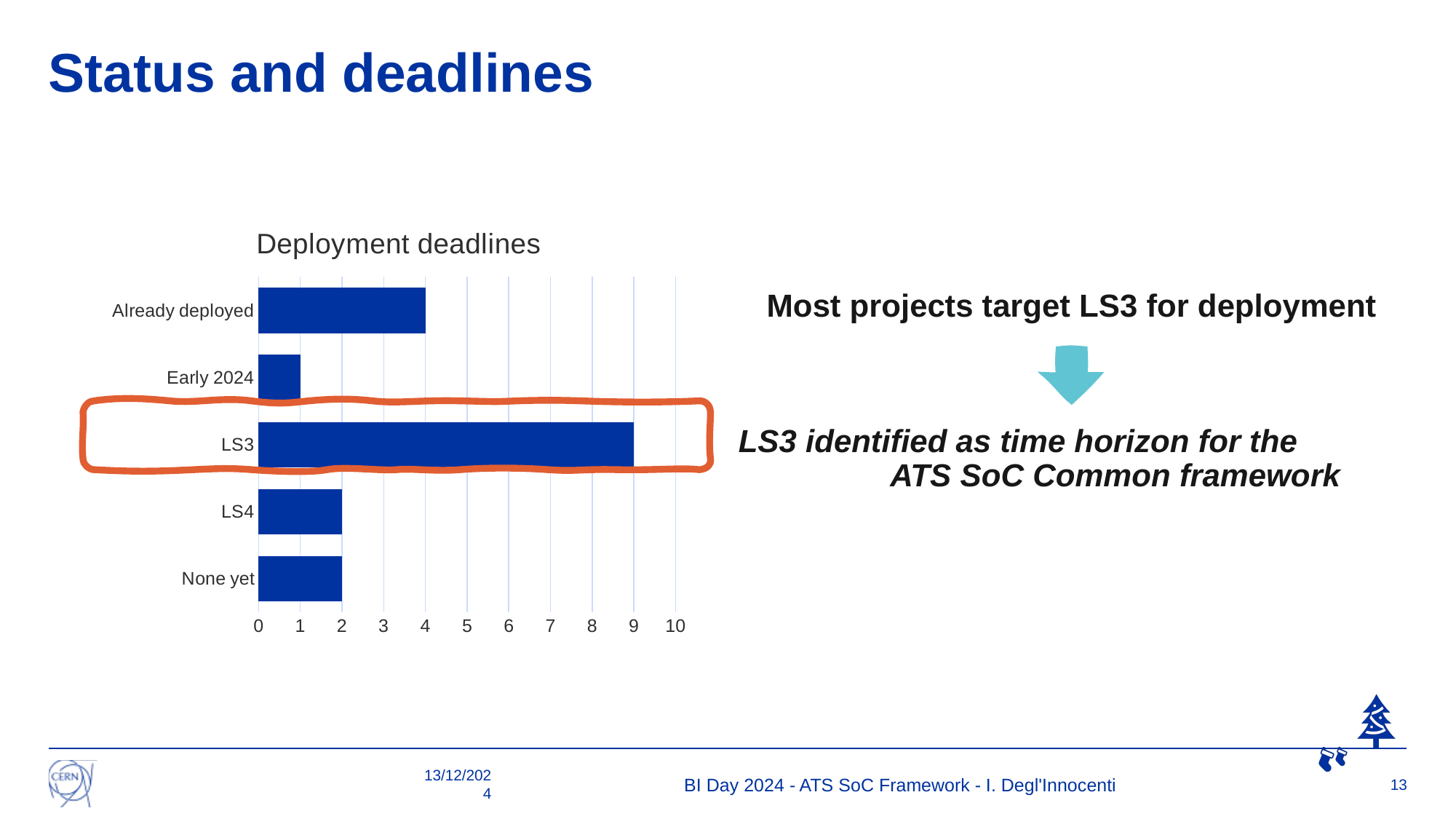
What is the value for Already deployed? 4 What is the difference between the values for LS3 and Already deployed? 5 Which is larger, the value for Already deployed or the value for LS4? Already deployed What is the value for LS3? 9 Is the value for LS3 greater or less than 8? greater How many categories does the chart show? 5 What is the title of the chart? Deployment deadlines What is the value for LS4? 2 Which category has the highest value? LS3 What kind of chart is shown on the slide? bar chart Which category has the lowest value? Early 2024 What is the value for Early 2024? 1